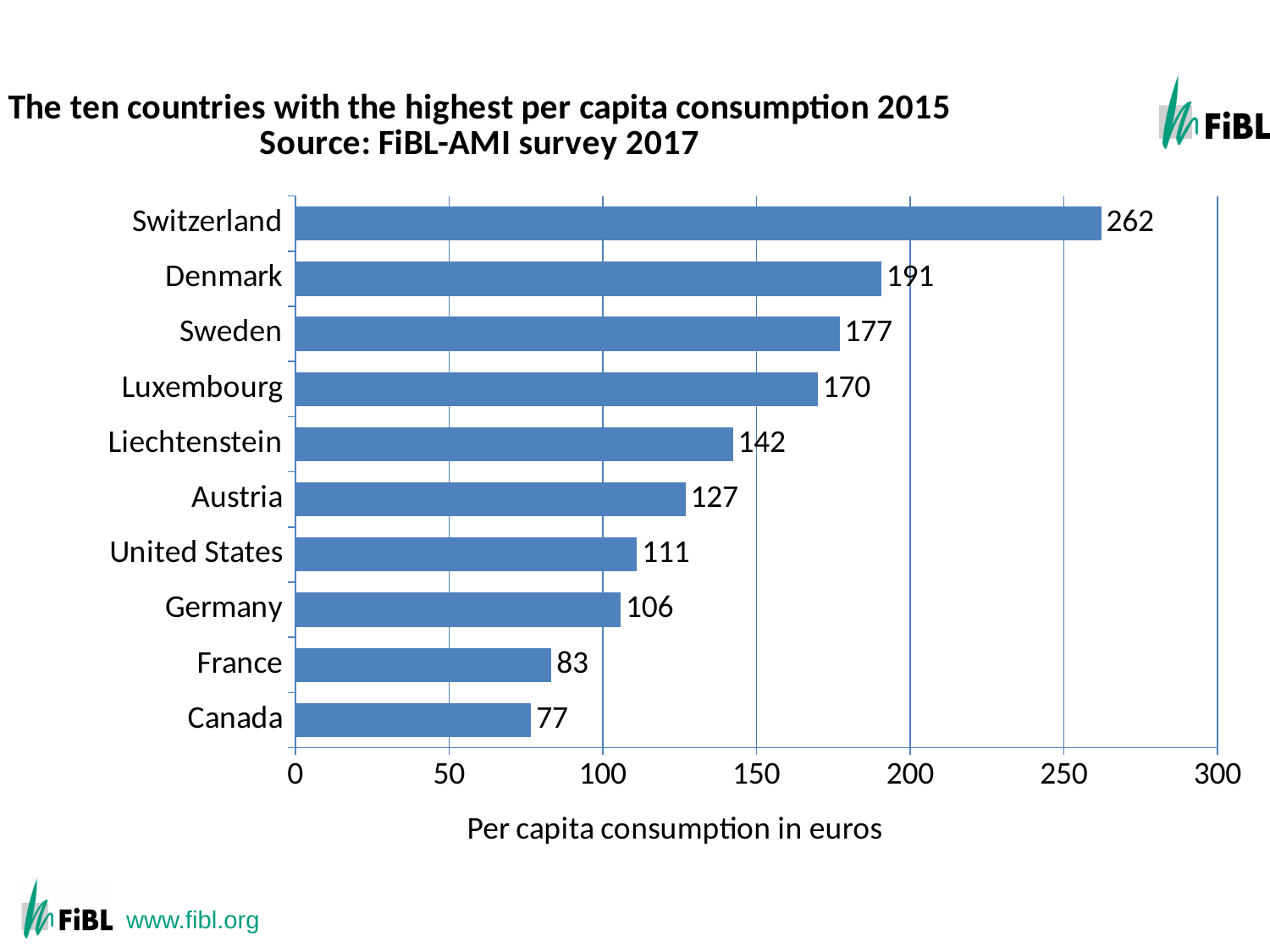
What kind of chart is shown on the slide? Bar chart What is the per capita consumption for Liechtenstein? 142 Which country has the highest per capita consumption? Switzerland Is the value for Austria greater or less than 150? less What is the per capita consumption for Switzerland? 262 Which country has the lowest per capita consumption? Canada What is the per capita consumption for Germany? 106 What is the label of the horizontal axis? Per capita consumption in euros What is the difference in per capita consumption between France and Canada? 6 How many countries are shown in the chart? 10 What is the difference in per capita consumption between Switzerland and Denmark? 71 Which has a higher per capita consumption, Sweden or Luxembourg? Sweden